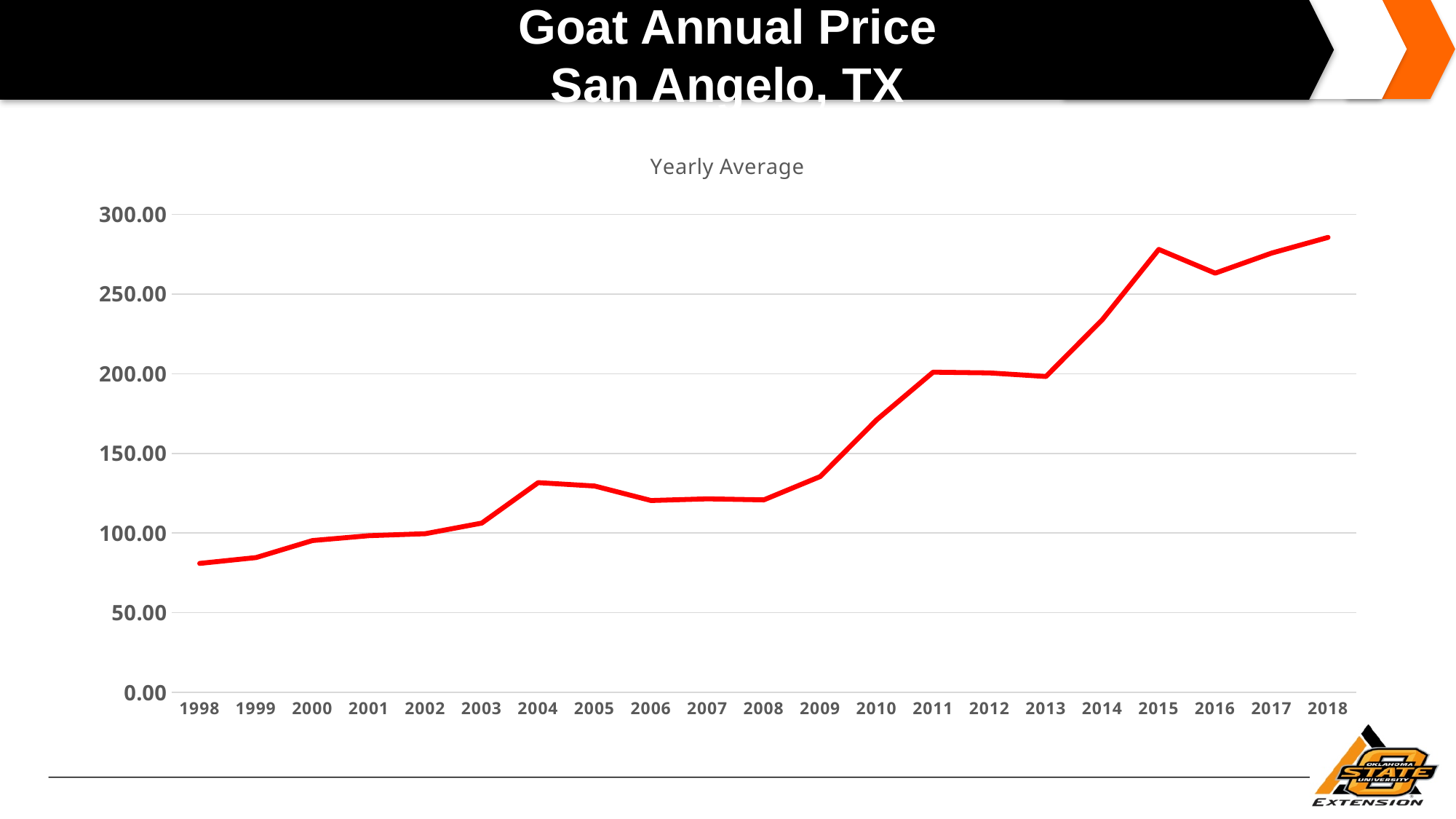
How many years are plotted along the x axis of the chart? 21 Is the value for 2018 greater or less than 300.00? less Is the value for 2004 greater or less than 100.00? greater What kind of chart is shown on the slide? line chart Is the value for 2015 greater or less than 250.00? greater What is the title shown above the plot area of the chart? Yearly Average Which year has the lowest yearly average price? 1998 Which year has the highest yearly average price? 2018 Overall, do the yearly average prices rise or fall from 1998 to 2018? rise Which year has the higher yearly average price, 2015 or 2016? 2015